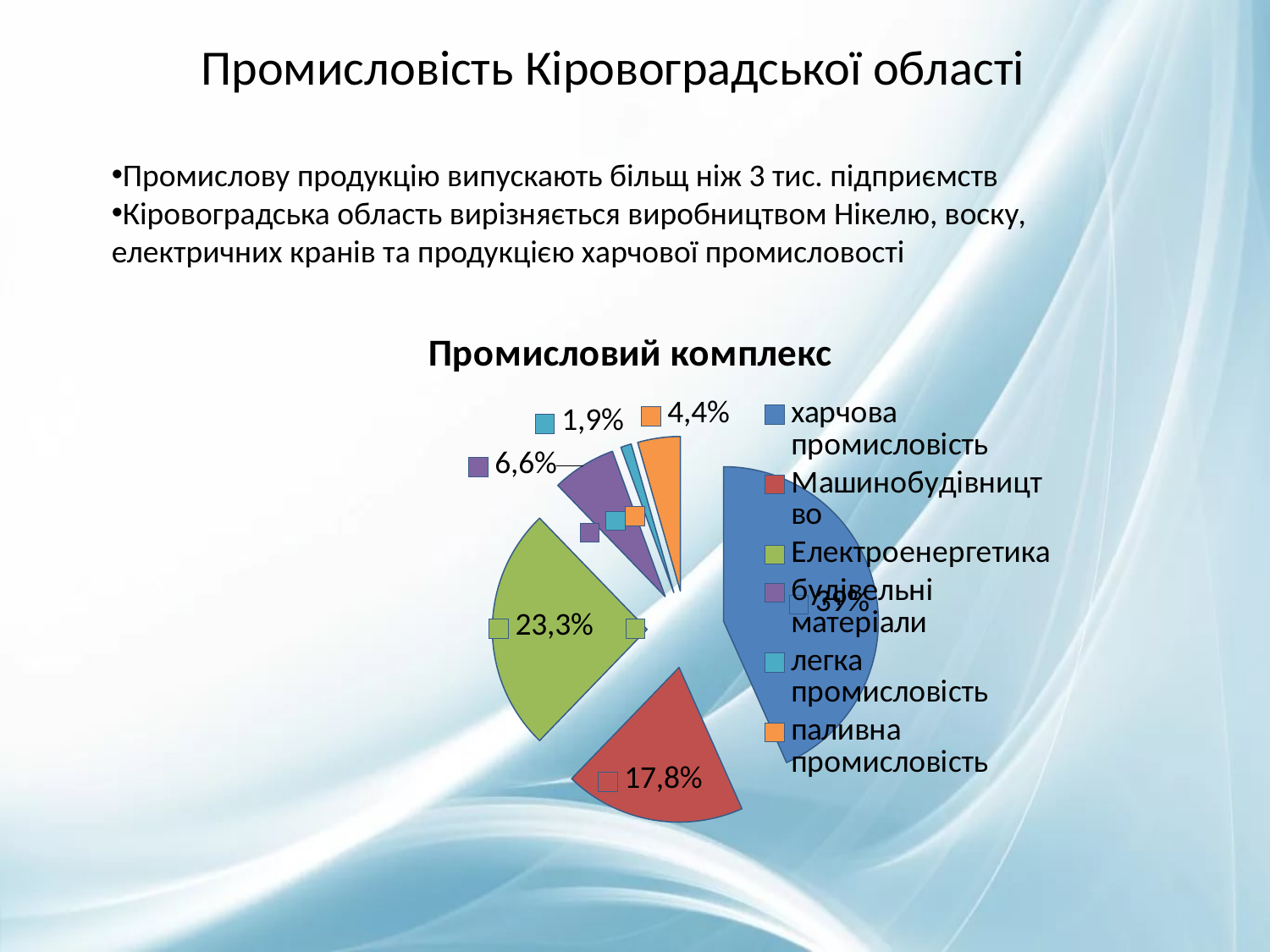
What share does легка промисловість have in the pie chart? 1,9% What is the difference between the shares of Електроенергетика and Машинобудівництво? 5,5% Which category has the largest slice in the pie chart? харчова промисловість What is the title of the chart? Промисловий комплекс What share do будівельні матеріали have in the pie chart? 6,6% What share does Машинобудівництво have in the pie chart? 17,8% What share does паливна промисловість have in the pie chart? 4,4% Which category has the smallest slice in the pie chart? легка промисловість What kind of chart is shown on the slide? pie chart Which is larger, the share of Електроенергетика or the share of Машинобудівництво? Електроенергетика How many slices does the pie chart have? 6 What share does Електроенергетика have in the pie chart? 23,3%